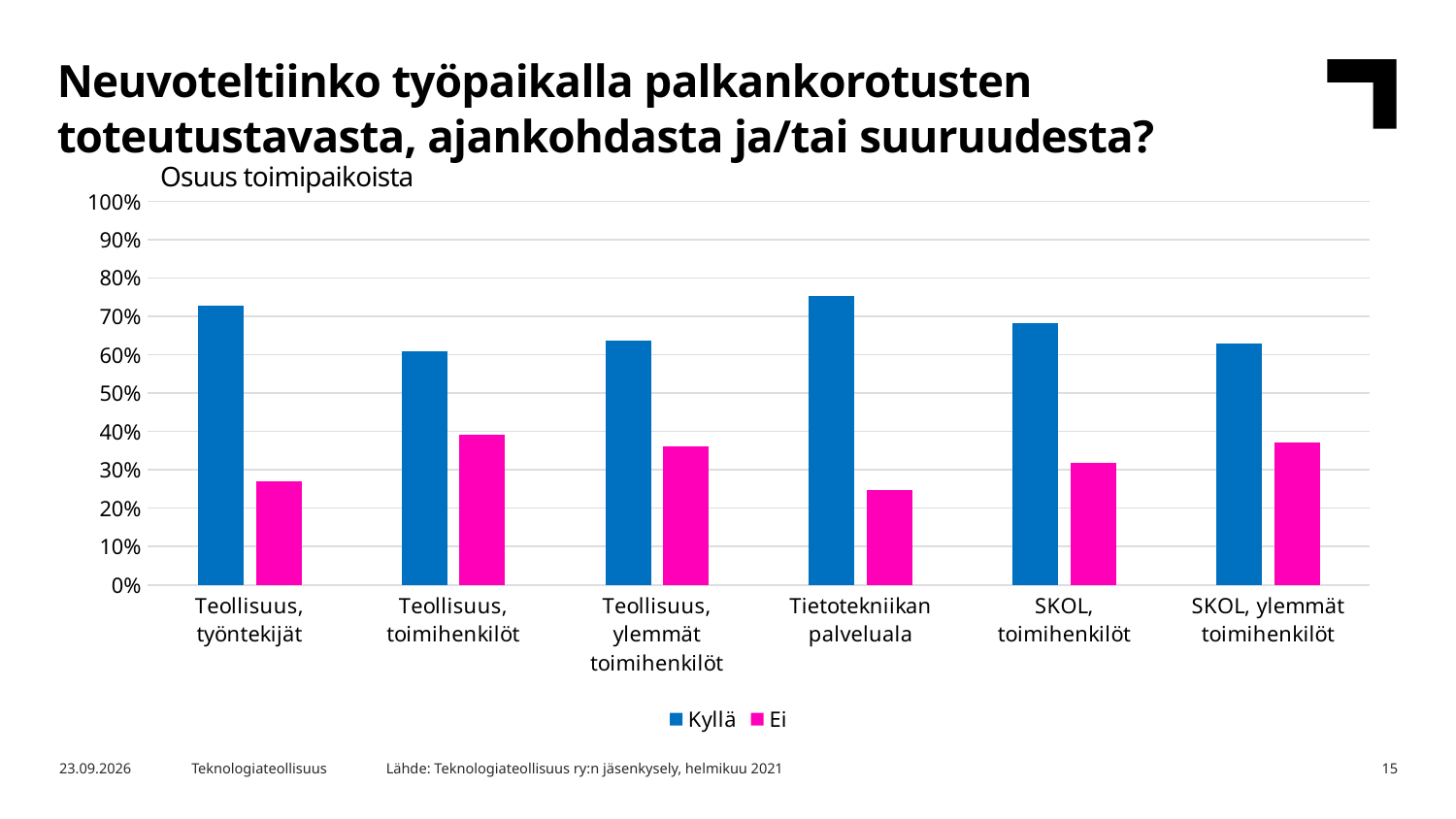
How many series does the legend list? 2 Which is larger, the Kyllä value for Teollisuus, työntekijät or the Kyllä value for Teollisuus, toimihenkilöt? Teollisuus, työntekijät Is the Kyllä value for Tietotekniikan palveluala greater or less than 70%? greater How many categories are shown on the x axis? 6 Which is larger, the Ei value for Teollisuus, toimihenkilöt or the Ei value for Tietotekniikan palveluala? Teollisuus, toimihenkilöt Is the Kyllä value for SKOL, toimihenkilöt greater or less than 70%? less Is the Ei value for Tietotekniikan palveluala greater or less than 30%? less What are the two series named in the legend? Kyllä and Ei What kind of chart is shown on the slide? bar chart